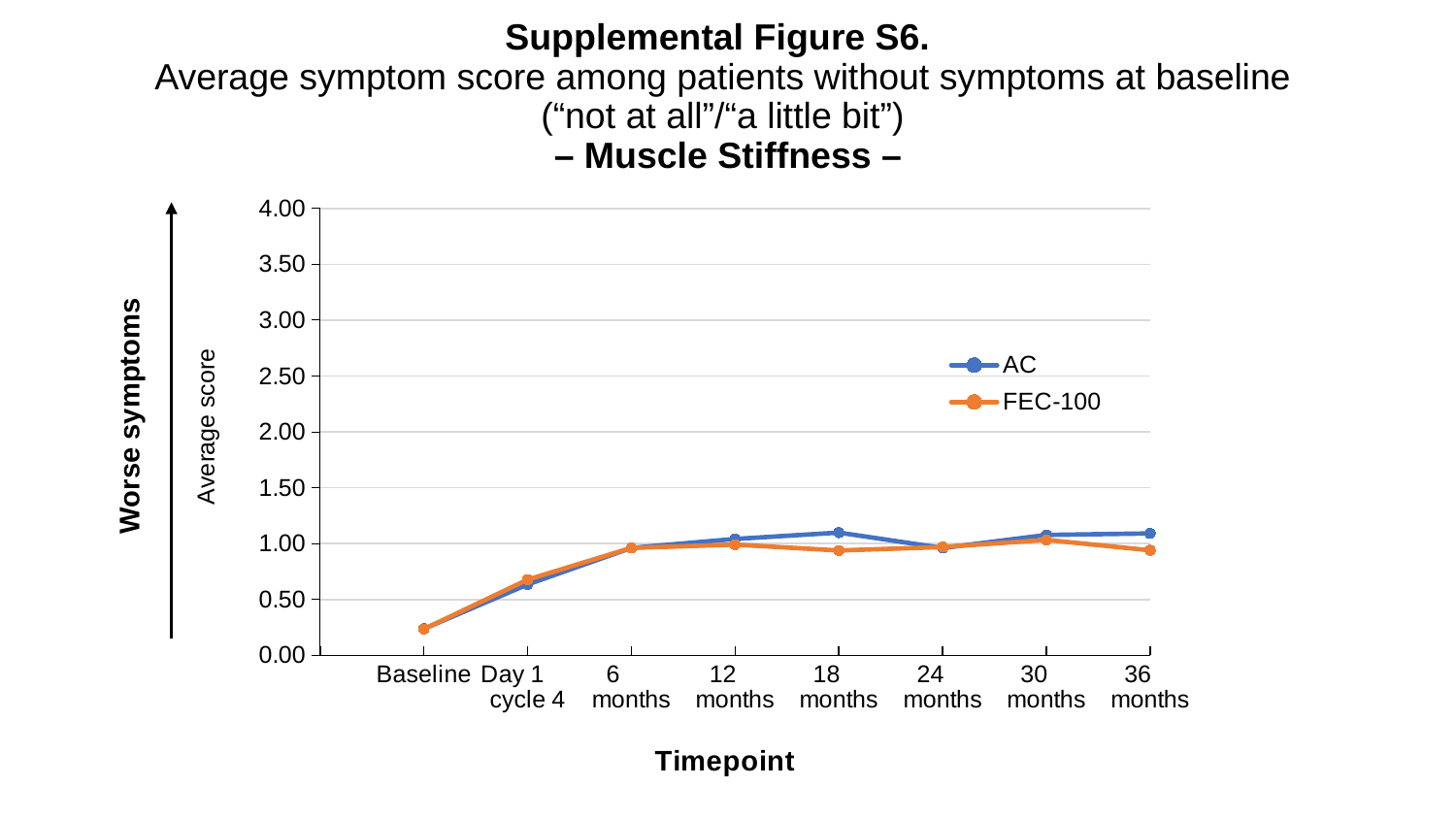
Is the value for AC at 18 months greater or less than 1.50? less How many series does the legend list? 2 At 18 months, which series has the higher value, AC or FEC-100? AC Is the value for FEC-100 at 36 months greater or less than 1.50? less How many timepoints are plotted along the x axis? 8 At 36 months, which series has the higher value, AC or FEC-100? AC Is the value for AC at Baseline greater or less than 0.50? less At which timepoint is the AC series lowest? Baseline What kind of chart is shown on the slide? line chart Which series are listed in the legend? AC and FEC-100 What is the title of the x axis? Timepoint